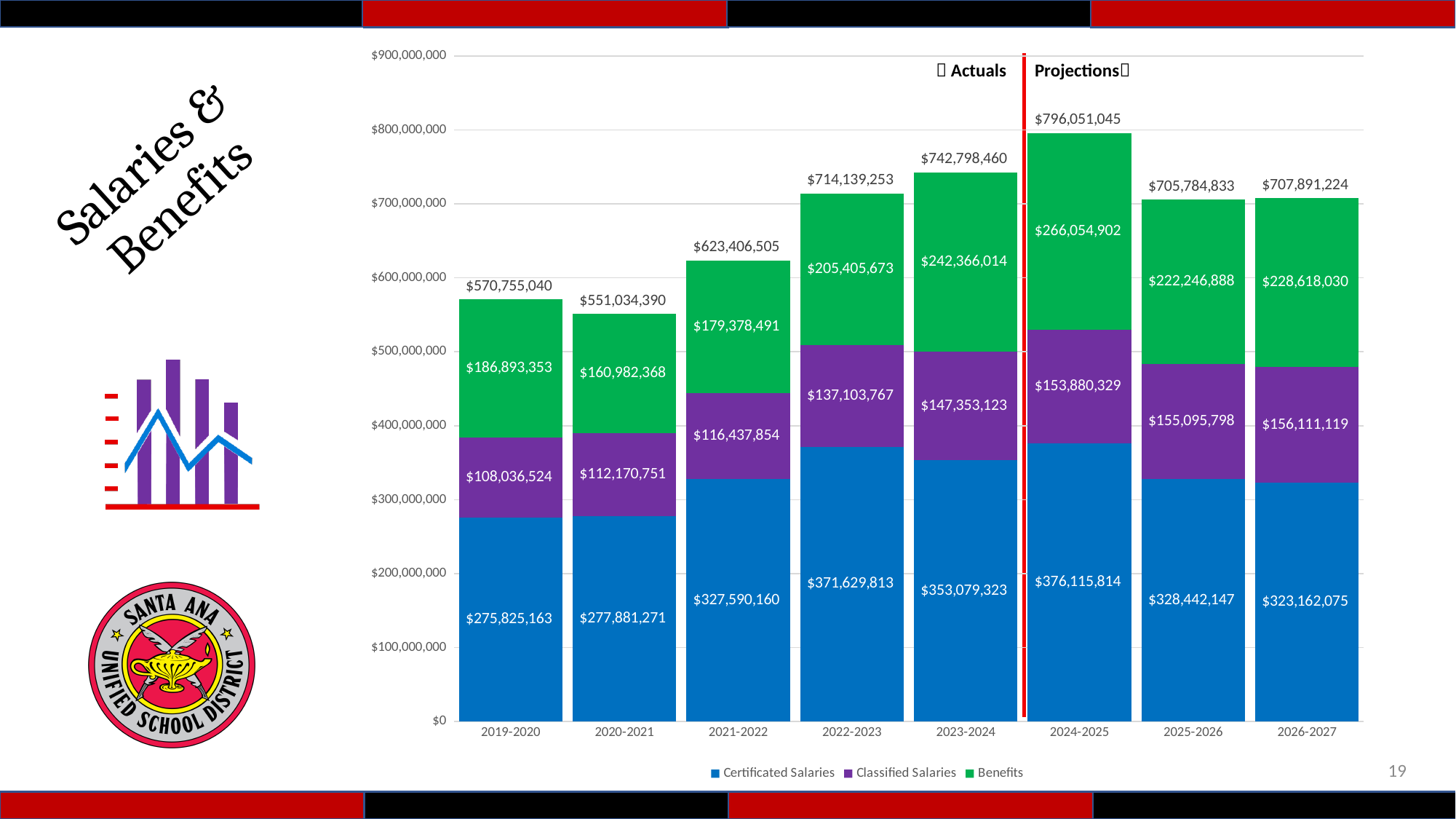
Which year has the lowest total for salaries and benefits? 2020-2021 What is the difference between Benefits in 2023-2024 and Benefits in 2022-2023? $36,960,341 How many fiscal years are shown on the x axis? 8 What is the value of Certificated Salaries for 2022-2023? $371,629,813 Which is larger: Certificated Salaries in 2025-2026 or in 2026-2027? 2025-2026 Is the total for 2021-2022 greater or less than $600,000,000? greater What is the value of Benefits for 2024-2025? $266,054,902 How many series does the legend list? 3 Which year has the highest total for salaries and benefits? 2024-2025 What kind of chart is shown on the slide? Stacked bar chart What is the total of the stacked bar for 2024-2025? $796,051,045 What is the value of Classified Salaries for 2020-2021? $112,170,751